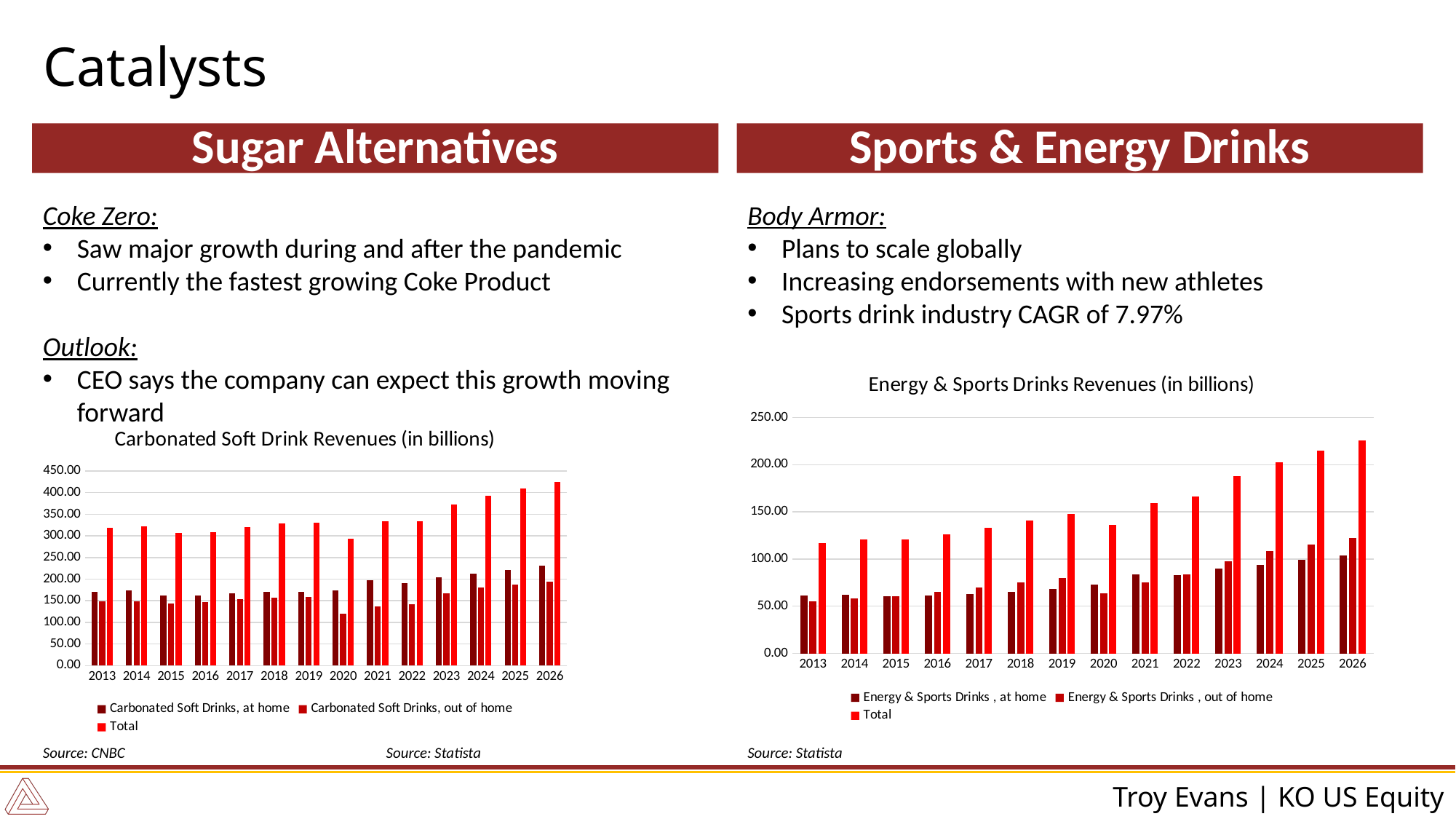
How many series does the legend of the 'Energy & Sports Drinks Revenues (in billions)' chart list? 3 In the 'Energy & Sports Drinks Revenues (in billions)' chart, does the Total rise or fall from 2013 to 2026? rise In the 'Energy & Sports Drinks Revenues (in billions)' chart, which year has the highest Total? 2026 In the 'Carbonated Soft Drink Revenues (in billions)' chart, which year has the lowest Total? 2020 In the 'Energy & Sports Drinks Revenues (in billions)' chart, is the Total for 2026 greater or less than 200? greater In the 'Carbonated Soft Drink Revenues (in billions)' chart, is the Total for 2026 greater or less than 400? greater How many years are shown on the x axis of the 'Carbonated Soft Drink Revenues (in billions)' chart? 14 In the 'Energy & Sports Drinks Revenues (in billions)' chart, which year has the lowest Total? 2013 In the 'Carbonated Soft Drink Revenues (in billions)' chart, which year has the highest Total? 2026 In the 'Energy & Sports Drinks Revenues (in billions)' chart, which is larger in 2026: Energy & Sports Drinks, at home or Energy & Sports Drinks, out of home? Energy & Sports Drinks, out of home What kind of chart is the 'Carbonated Soft Drink Revenues (in billions)' chart? bar chart